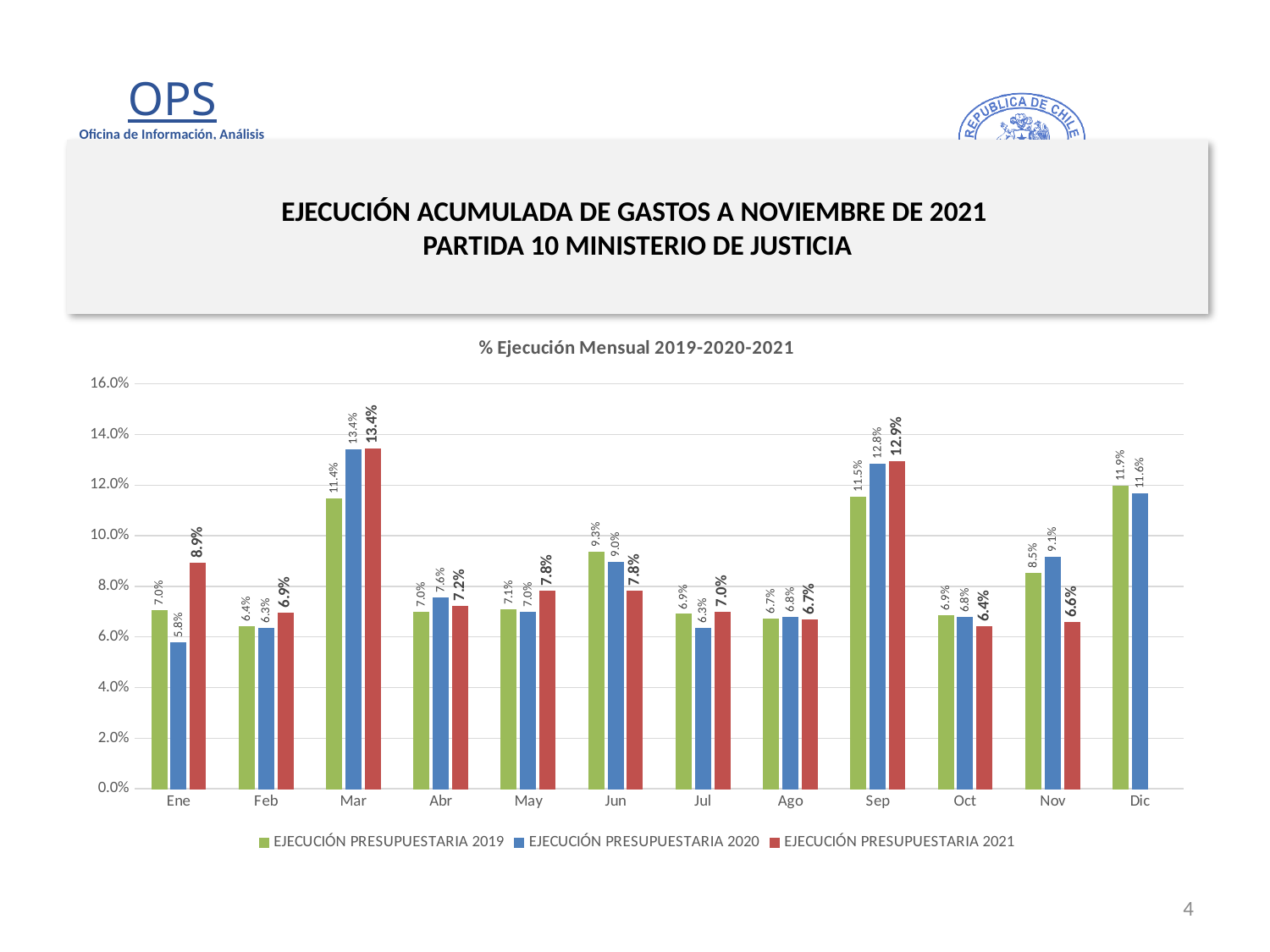
In Nov, which is larger: the EJECUCIÓN PRESUPUESTARIA 2020 value or the EJECUCIÓN PRESUPUESTARIA 2021 value? EJECUCIÓN PRESUPUESTARIA 2020 What is the difference between the EJECUCIÓN PRESUPUESTARIA 2021 and EJECUCIÓN PRESUPUESTARIA 2019 values in Ene? 1.9% What is the difference between the EJECUCIÓN PRESUPUESTARIA 2020 and EJECUCIÓN PRESUPUESTARIA 2019 values in Mar? 2.0% What is the value for EJECUCIÓN PRESUPUESTARIA 2019 in Dic? 11.9% Which month has the highest value for EJECUCIÓN PRESUPUESTARIA 2021? Mar What is the value for EJECUCIÓN PRESUPUESTARIA 2020 in Sep? 12.8% How many series does the legend list? 3 What kind of chart is shown on the slide? Bar chart How many months are shown on the x axis? 12 What is the value for EJECUCIÓN PRESUPUESTARIA 2021 in Ene? 8.9% Which month has the lowest value for EJECUCIÓN PRESUPUESTARIA 2020? Ene What is the title of the chart? % Ejecución Mensual 2019-2020-2021